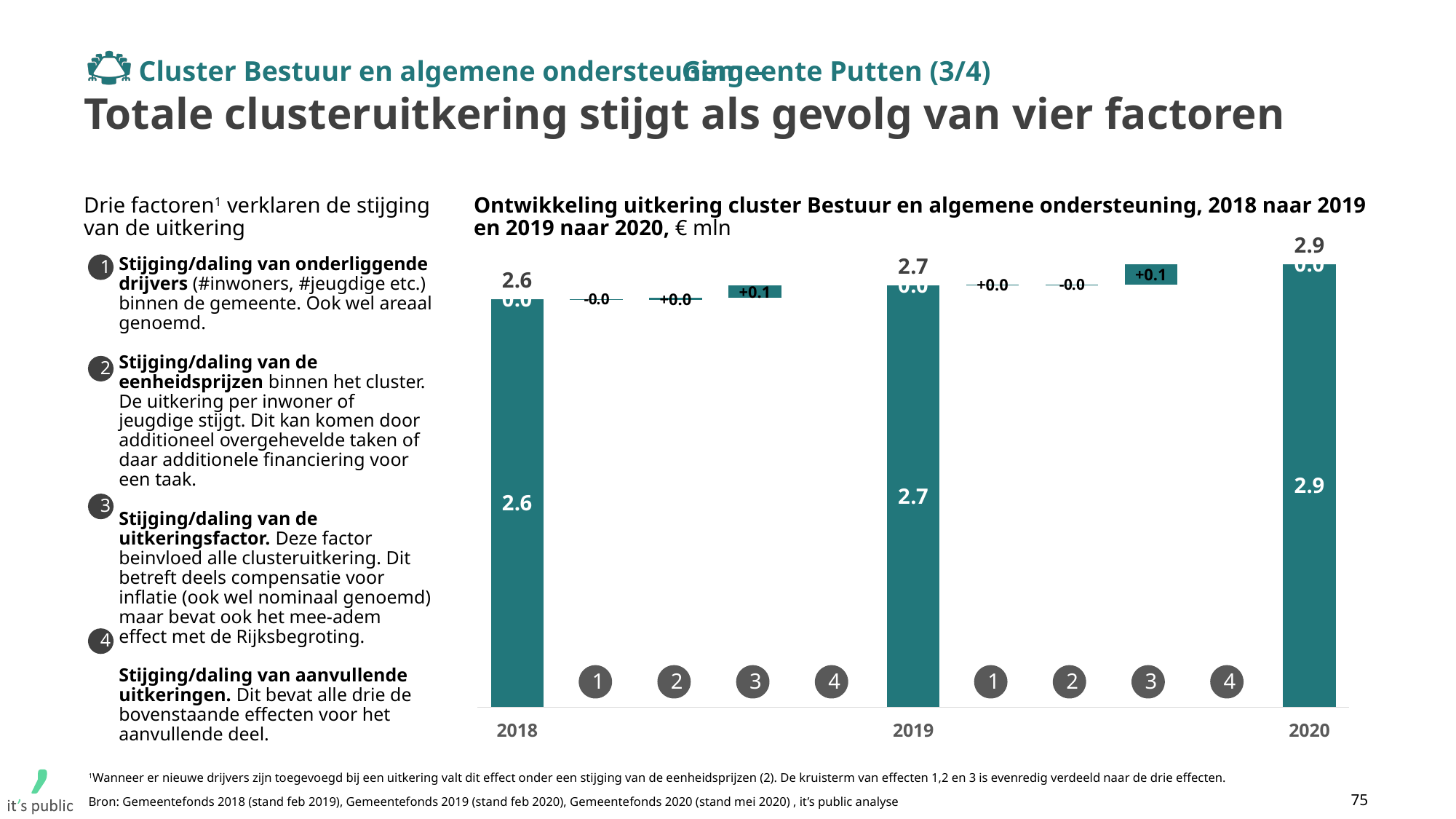
What is the total uitkering shown for 2019? 2.7 In what unit are the values in the chart expressed? € mln What is the value of the factor 3 step between 2019 and 2020? +0.1 What is the difference between the 2019 total and the 2018 total? 0.1 Which year has the lowest total uitkering in the chart? 2018 What is the total uitkering shown for 2018? 2.6 Which year has the highest total uitkering in the chart? 2020 What is the total uitkering shown for 2020? 2.9 How many year totals are shown in the chart? 3 Do the total values rise or fall from 2018 to 2020? rise What is the value of the factor 3 step between 2018 and 2019? +0.1 What is the difference between the 2020 total and the 2018 total? 0.3